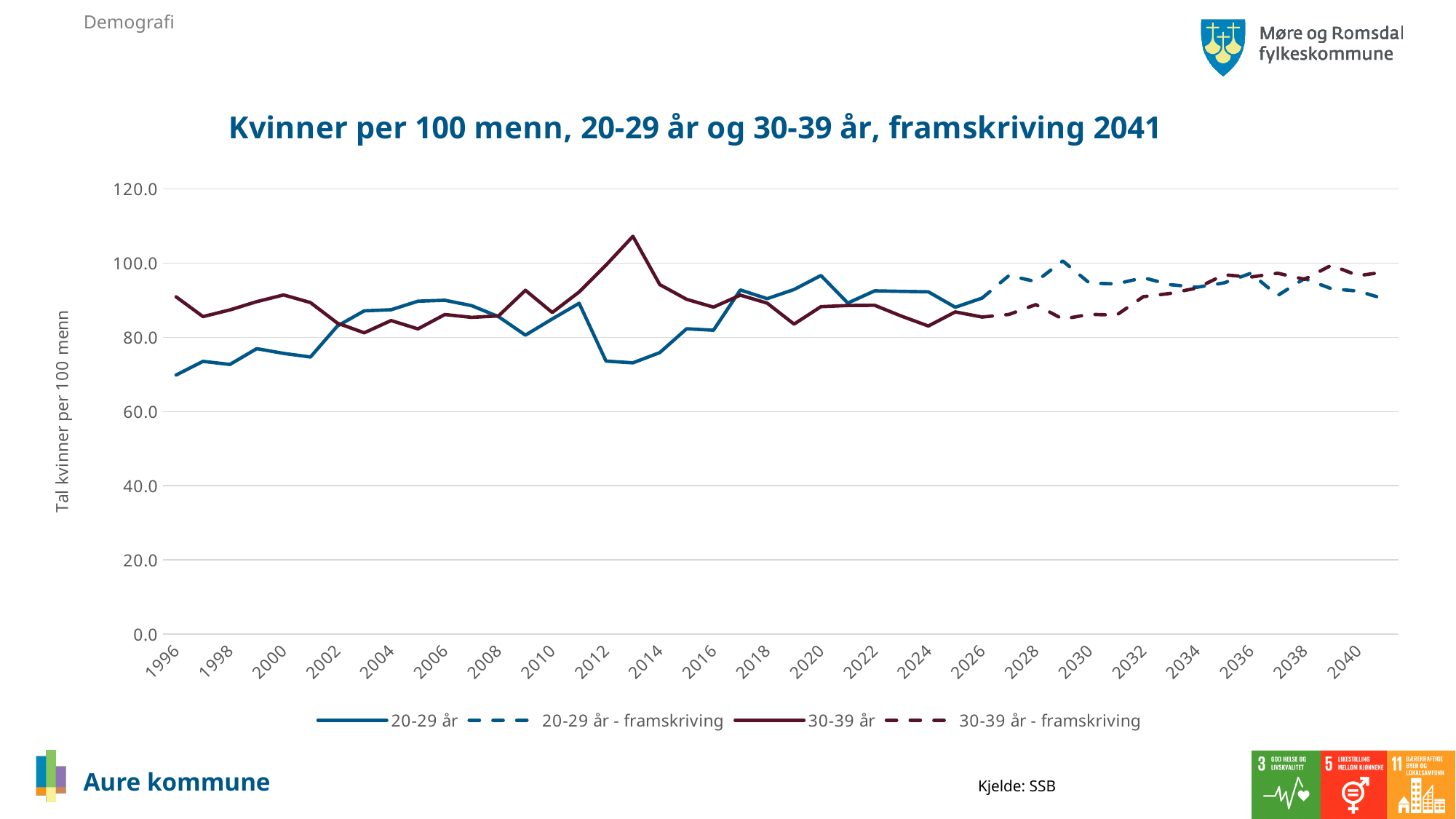
In 2020, which series has the higher value, 20-29 år or 30-39 år? 20-29 år In 1996, which series has the higher value, 20-29 år or 30-39 år? 30-39 år Does the 30-39 år series rise or fall between 2013 and 2016? fall Is the value for 20-29 år in 1996 greater or less than 80? less Is the value for 30-39 år in 1996 greater or less than 80? greater What kind of chart is shown on the slide? line chart What is the title of the chart? Kvinner per 100 menn, 20-29 år og 30-39 år, framskriving 2041 Is the value for 20-29 år in 2012 greater or less than 80? less What is the label on the vertical axis? Tal kvinner per 100 menn How many series does the legend list? 4 In which year does the 30-39 år series reach its highest value? 2013